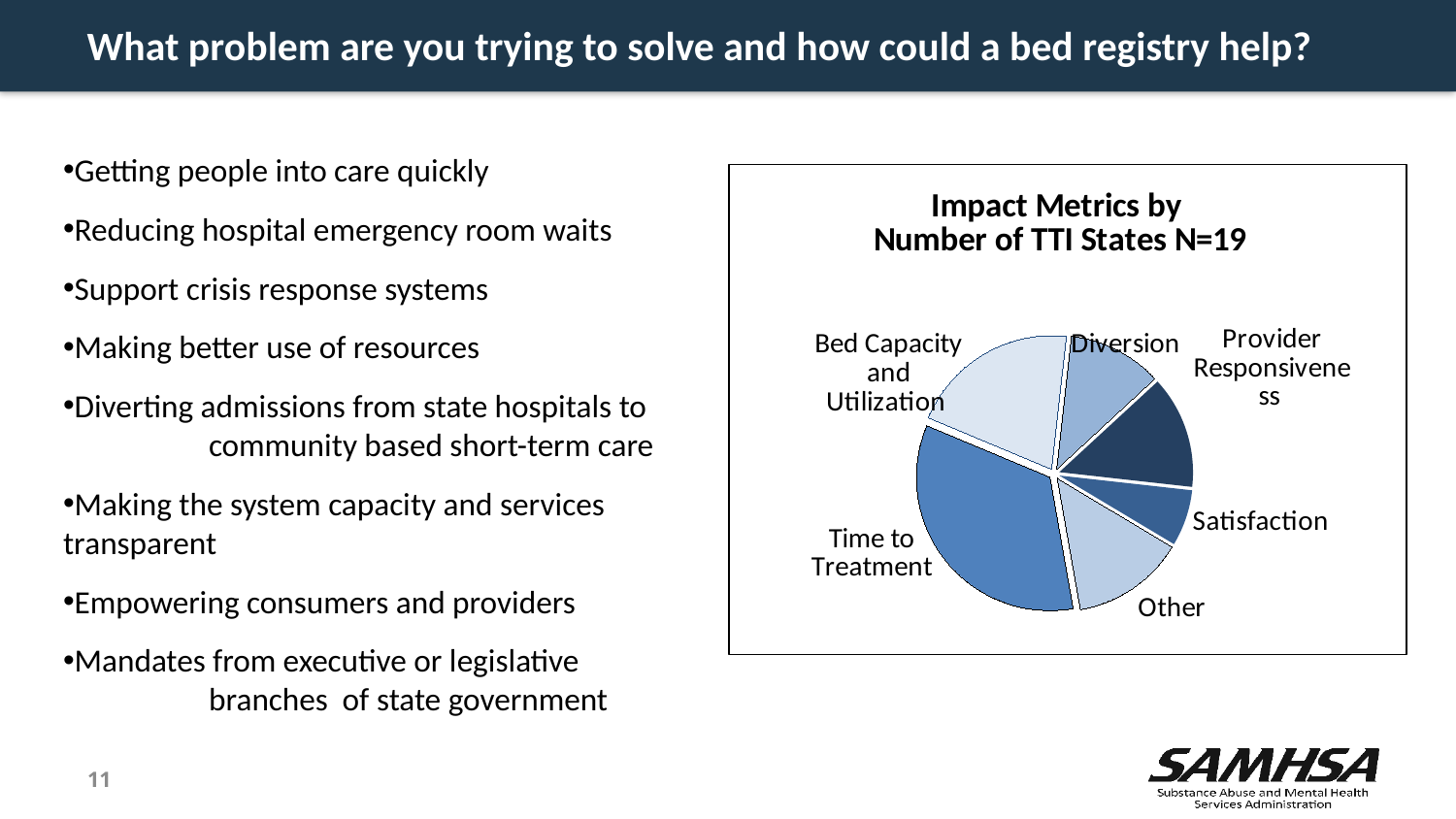
Which category has the largest slice of the pie chart? Time to Treatment According to the chart title, how many TTI states are represented (N)? 19 Which slice is larger, Time to Treatment or Diversion? Time to Treatment Which category has the smallest slice of the pie chart? Satisfaction What is the title of the pie chart? Impact Metrics by Number of TTI States N=19 Which slice is larger, Provider Responsiveness or Satisfaction? Provider Responsiveness What kind of chart is shown on the slide? pie chart Which slice is larger, Bed Capacity and Utilization or Other? Bed Capacity and Utilization How many slices does the pie chart have? 6